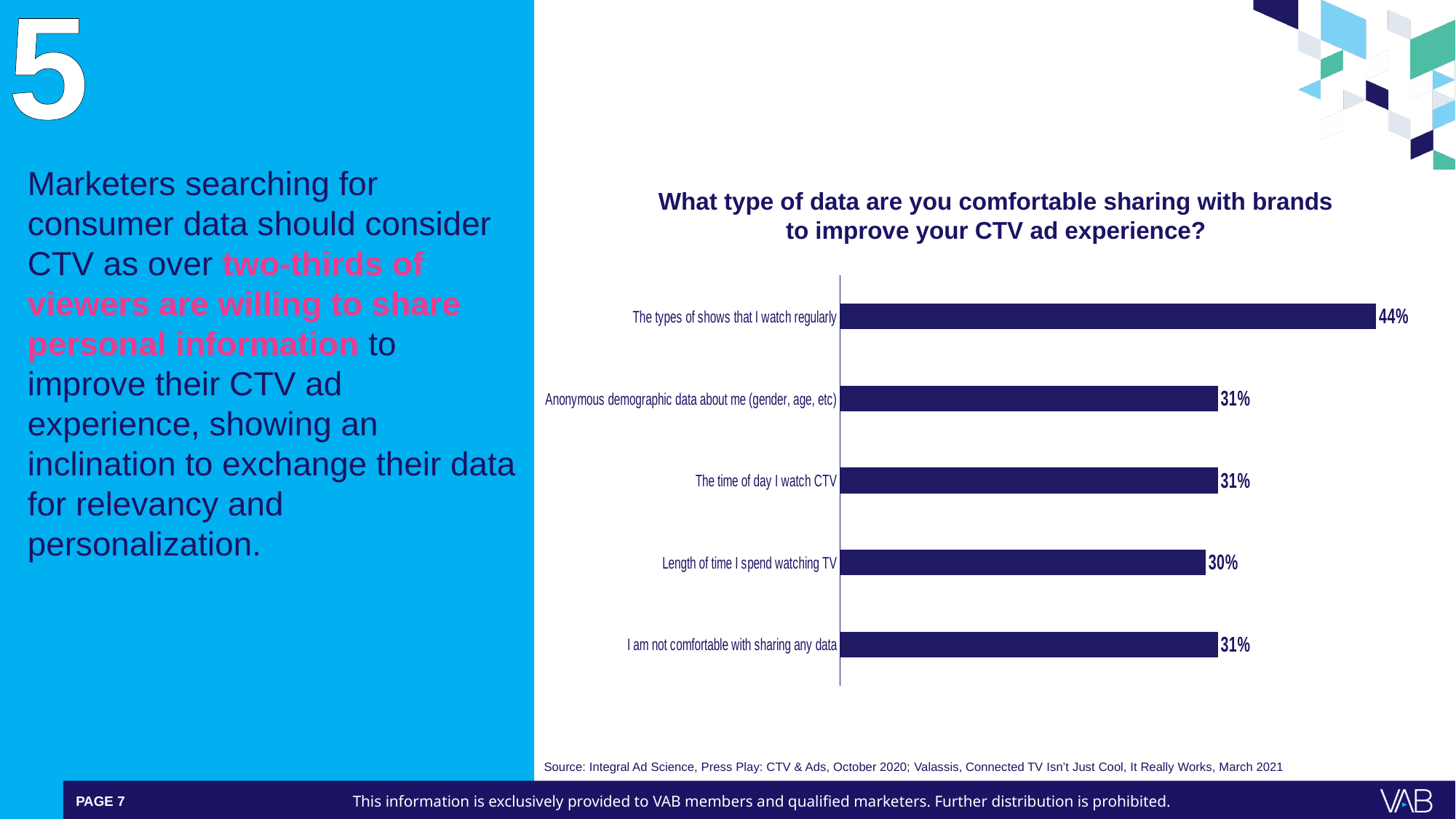
What is the value for 'Anonymous demographic data about me (gender, age, etc)'? 31% What type of chart is shown on the slide? Bar chart What percentage of respondents are comfortable sharing the types of shows they watch regularly? 44% What is the value for 'The time of day I watch CTV'? 31% Which category has the highest value? The types of shows that I watch regularly How many categories are shown in the chart? 5 Which category has the lowest value? Length of time I spend watching TV What is the difference between the value for 'The types of shows that I watch regularly' and 'The time of day I watch CTV'? 13% What is the title of the chart? What type of data are you comfortable sharing with brands to improve your CTV ad experience? What is the value for 'Length of time I spend watching TV'? 30% Which is larger: the value for 'The types of shows that I watch regularly' or 'Length of time I spend watching TV'? The types of shows that I watch regularly What percentage of respondents said they are not comfortable with sharing any data? 31%